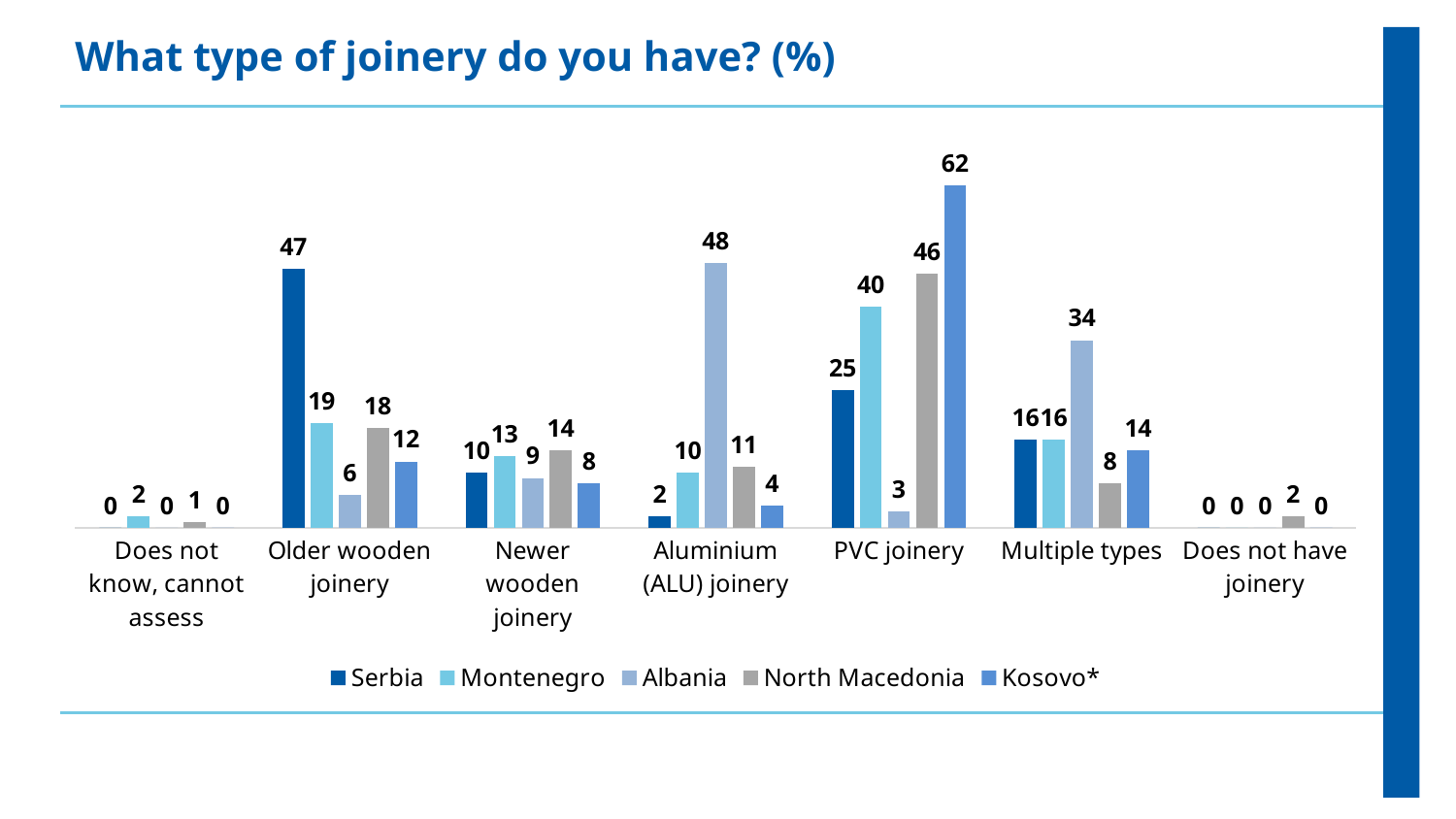
What is the value for Kosovo* in the PVC joinery category? 62 How many joinery categories are shown on the x axis? 7 What is the value for Albania in the Aluminium (ALU) joinery category? 48 How many series does the legend list? 5 What kind of chart is shown on the slide? Bar chart Which is larger: Albania's value for Multiple types or Serbia's value for PVC joinery? Albania's value for Multiple types What is the value for North Macedonia in the Multiple types category? 8 What is the difference between Montenegro and Albania in the PVC joinery category? 37 Which country has the highest value in the PVC joinery category? Kosovo* What is the title of the chart? What type of joinery do you have? (%) Which country has the lowest value in the Older wooden joinery category? Albania What is the value for Serbia in the Older wooden joinery category? 47